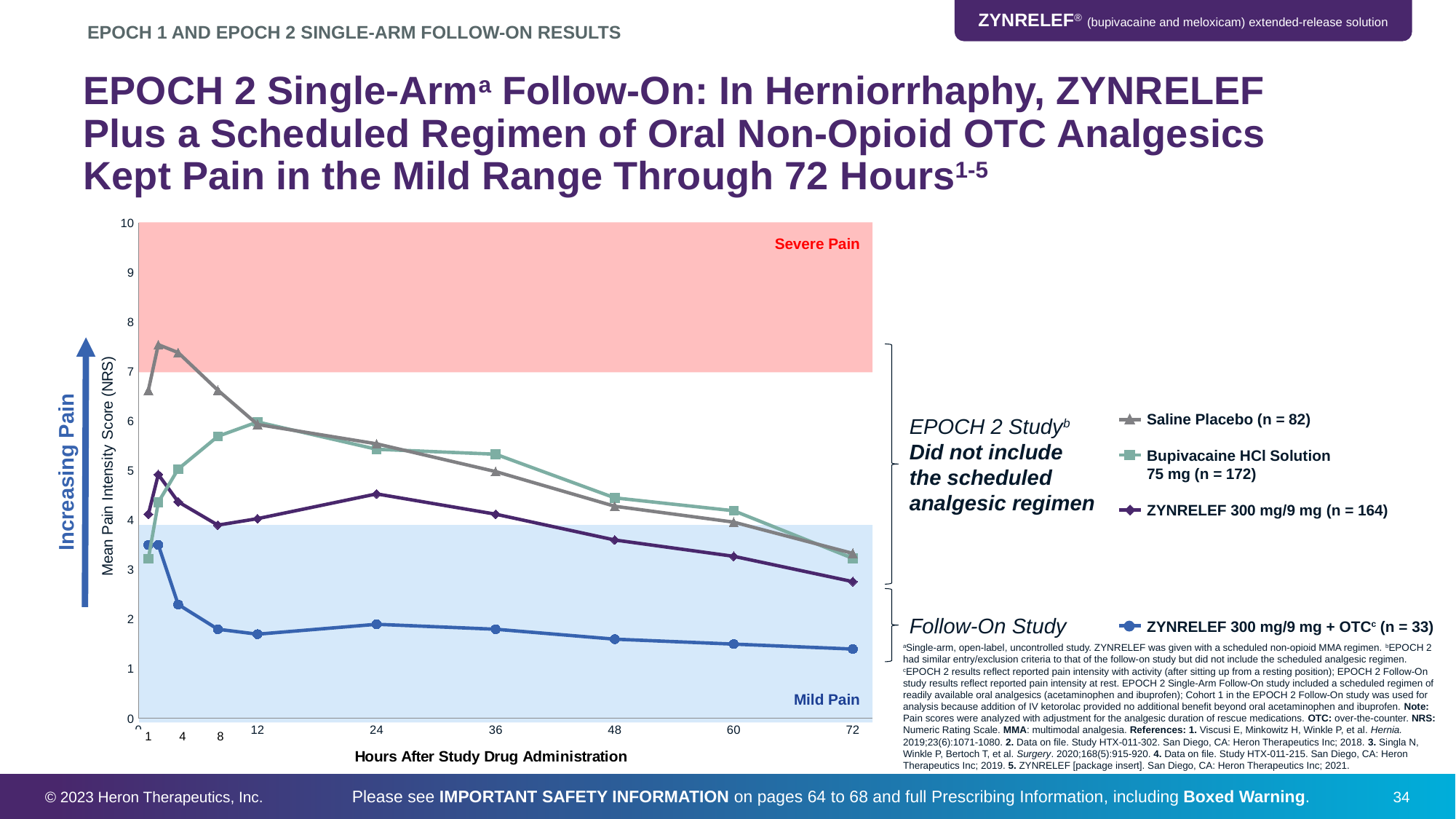
At 12 hours, which is larger: Bupivacaine HCl Solution 75 mg or ZYNRELEF 300 mg/9 mg + OTC? Bupivacaine HCl Solution 75 mg Which series has the highest mean pain intensity score at 1 hour? Saline Placebo Is the value for Saline Placebo at 1 hour greater or less than 7? less What kind of chart is shown on the slide? line chart At 72 hours, which is larger: ZYNRELEF 300 mg/9 mg or ZYNRELEF 300 mg/9 mg + OTC? ZYNRELEF 300 mg/9 mg Is the value for Bupivacaine HCl Solution 75 mg at 12 hours greater or less than 5? greater Which series has the lowest mean pain intensity score at 72 hours? ZYNRELEF 300 mg/9 mg + OTC Is the value for ZYNRELEF 300 mg/9 mg at 24 hours greater or less than 4? greater What is the title of the x axis? Hours After Study Drug Administration How many series does the legend list? 4 Does the Saline Placebo line rise or fall from 12 hours to 72 hours? fall